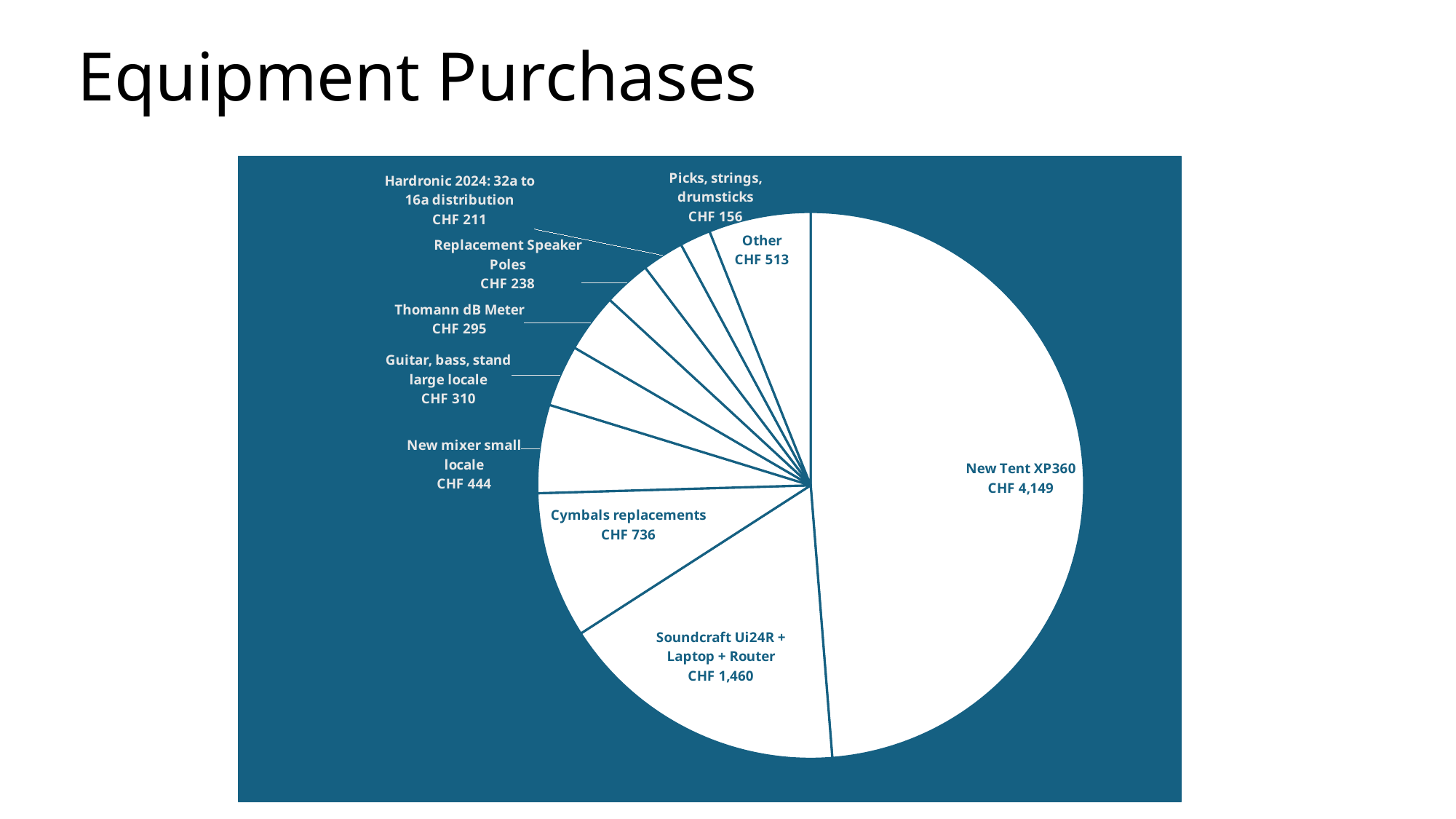
What is the value for New Tent XP360? CHF 4,149 What is the difference between New Tent XP360 and Soundcraft Ui24R + Laptop + Router? CHF 2,689 How many slices does the pie chart have? 10 What is the title of the slide? Equipment Purchases What is the value for the Other slice? CHF 513 What is the value for Thomann dB Meter? CHF 295 What is the value for Cymbals replacements? CHF 736 What is the value for Soundcraft Ui24R + Laptop + Router? CHF 1,460 Which category has the largest slice of the pie? New Tent XP360 Which is larger, New mixer small locale or Guitar, bass, stand large locale? New mixer small locale Which category has the smallest slice of the pie? Picks, strings, drumsticks What kind of chart is shown on the slide? pie chart